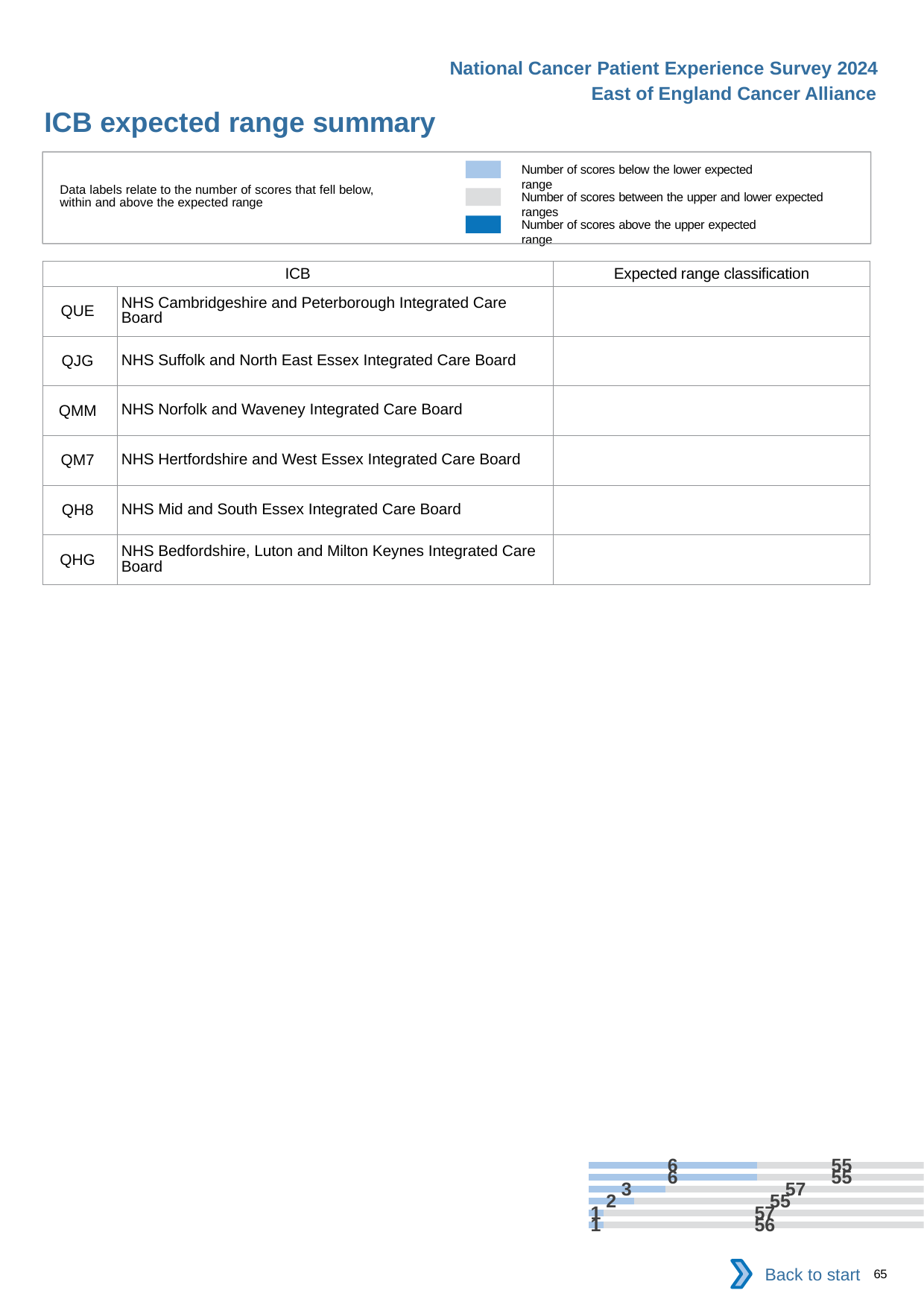
How many bars does the chart at the bottom right of the slide contain? 6 What is the largest value printed on a grey segment in the chart? 57 What is the largest value printed on a light blue segment in the chart? 6 What is the smallest value printed on a grey segment in the chart? 55 How many entries does the legend box at the top of the slide list? 3 According to the legend, what does the light blue colour represent? Number of scores below the lower expected range What is the smallest value printed on a light blue segment in the chart? 1 According to the legend, what does the dark blue colour represent? Number of scores above the upper expected range What kind of chart is shown at the bottom right of the slide? bar chart